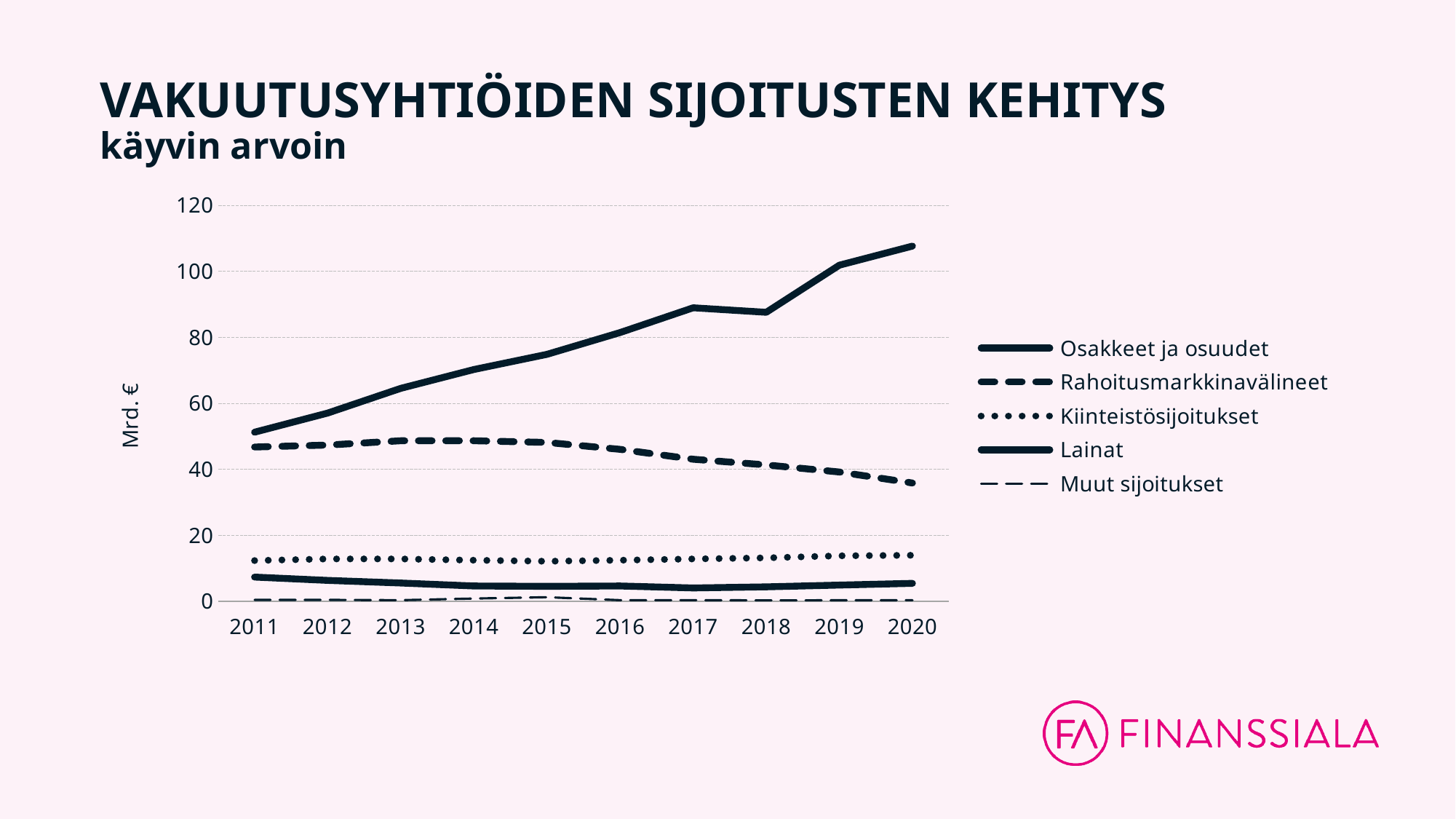
How many series does the legend list? 5 In 2017, which is larger: Osakkeet ja osuudet or Rahoitusmarkkinavälineet? Osakkeet ja osuudet What kind of chart is shown on the slide? line chart Which series has the lowest value in 2020? Muut sijoitukset Does the value for Osakkeet ja osuudet rise or fall from 2011 to 2020? rise Which series has the highest value in 2020? Osakkeet ja osuudet How many years are shown on the x axis? 10 Is the value for Osakkeet ja osuudet in 2011 greater or less than 60? less Is the value for Kiinteistösijoitukset in 2020 greater or less than 20? less Is the value for Rahoitusmarkkinavälineet in 2020 greater or less than 40? less Does the value for Rahoitusmarkkinavälineet rise or fall from 2015 to 2020? fall